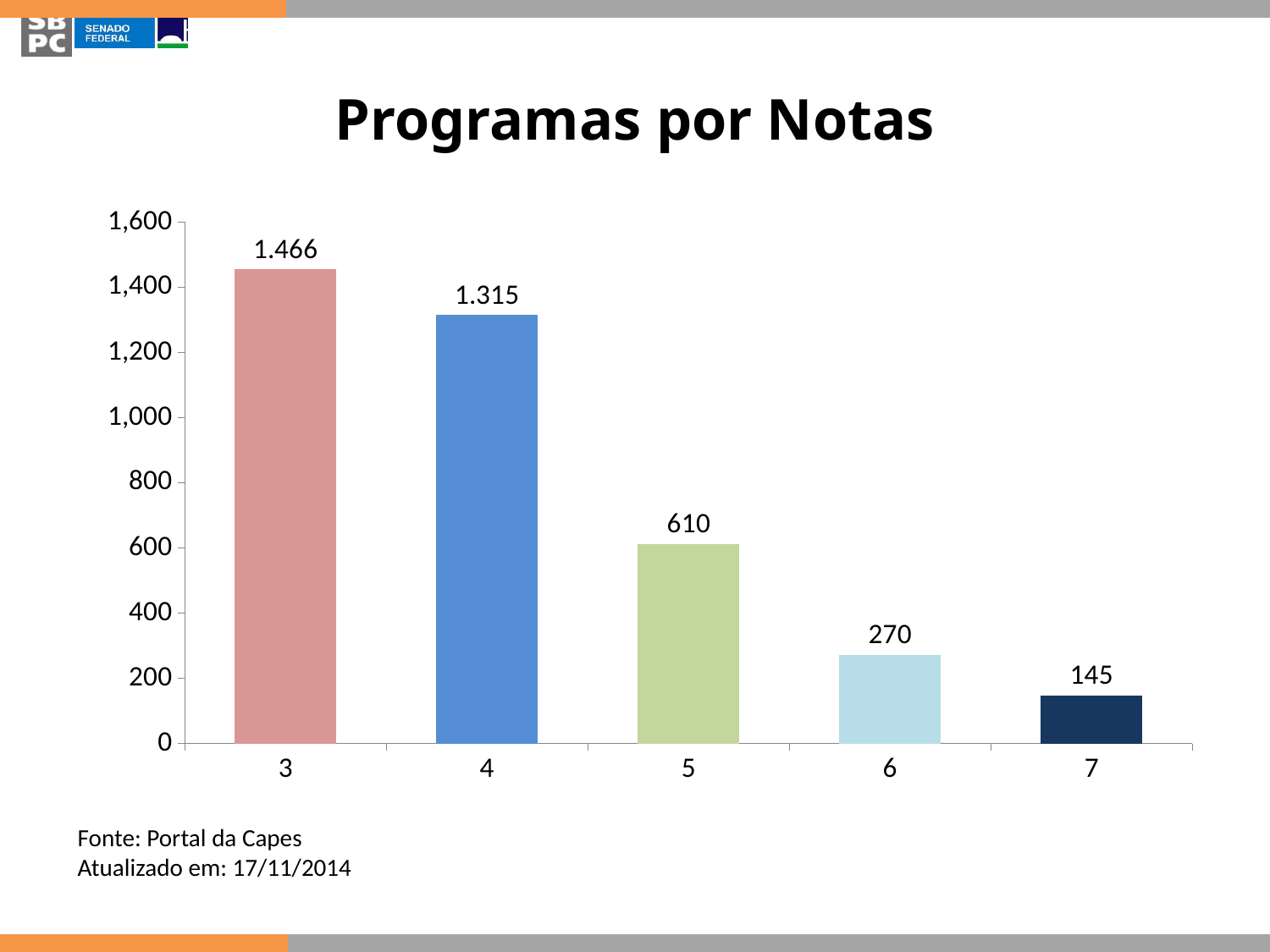
What is the difference between the values for nota 3 and nota 4? 151 What is the value for nota 5? 610 Which nota has the lowest number of programas? 7 Which nota has the highest number of programas? 3 How many notas (categories) are shown on the x axis? 5 Is the value for nota 4 greater or less than 1,200? greater What is the difference between the values for nota 5 and nota 6? 340 What is the value for nota 3? 1.466 What kind of chart is shown on the slide? bar chart Do the values rise or fall as the nota increases from 3 to 7? fall Which is larger, the value for nota 6 or the value for nota 7? nota 6 What is the value for nota 7? 145